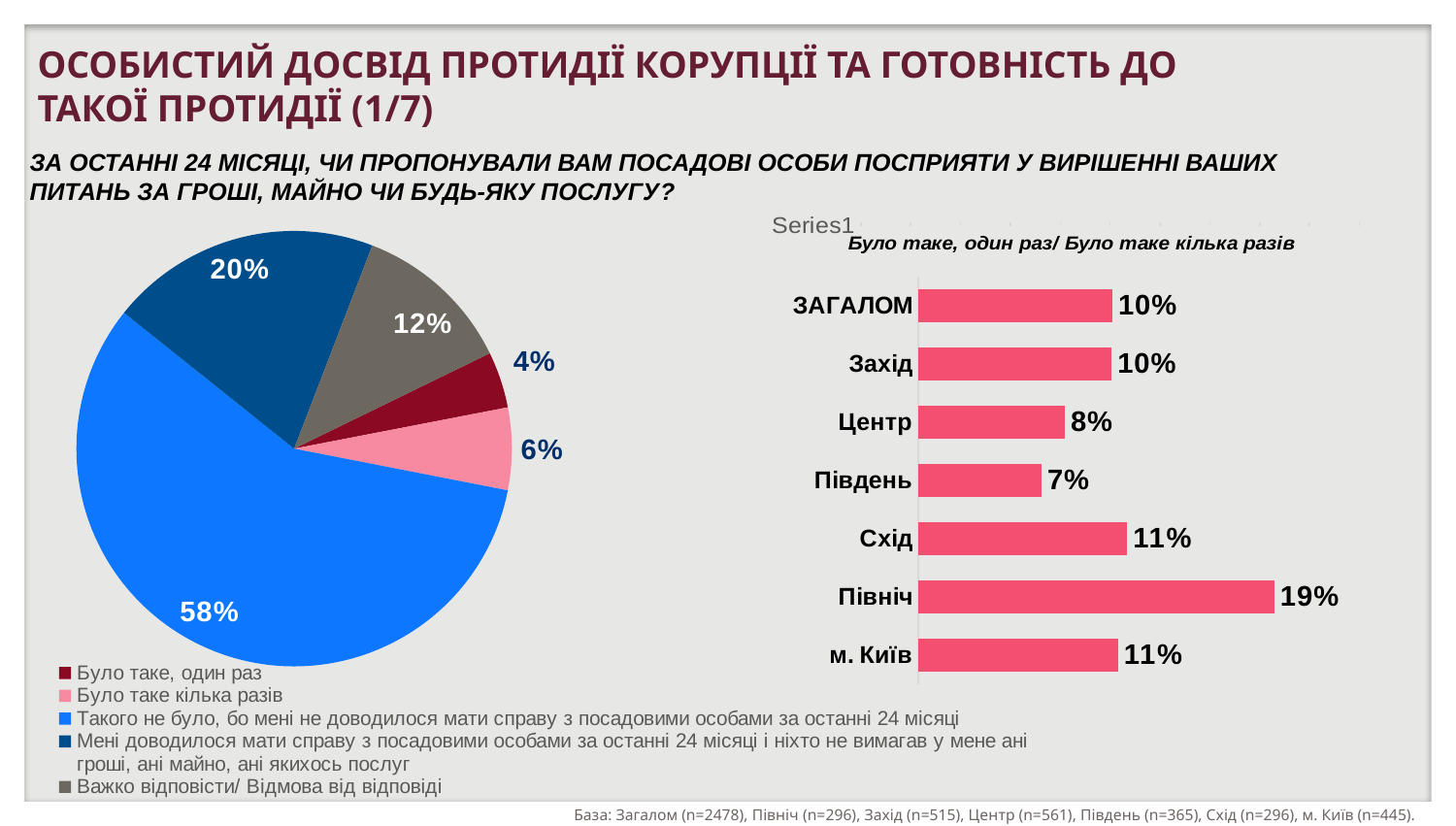
In the pie chart on the left, what share is labelled for the slice 'Було таке кілька разів'? 6% In the bar chart on the right, which region has the highest value? Північ What type of chart is shown on the right side of the slide? Bar chart In the bar chart on the right, which is larger: the value for Схід or the value for Захід? Схід In the bar chart on the right, what is the difference between the values for Північ and Центр? 11% In the bar chart on the right, which region has the lowest value? Південь In the pie chart on the left, what is the value for 'Важко відповісти/ Відмова від відповіді'? 12% In the pie chart on the left, what is the value of the largest slice? 58% In the bar chart on the right, what is the value for Південь? 7% In the bar chart on the right, what is the value for ЗАГАЛОМ? 10% In the bar chart on the right, what is the value for Північ? 19% How many categories are shown in the bar chart on the right? 7